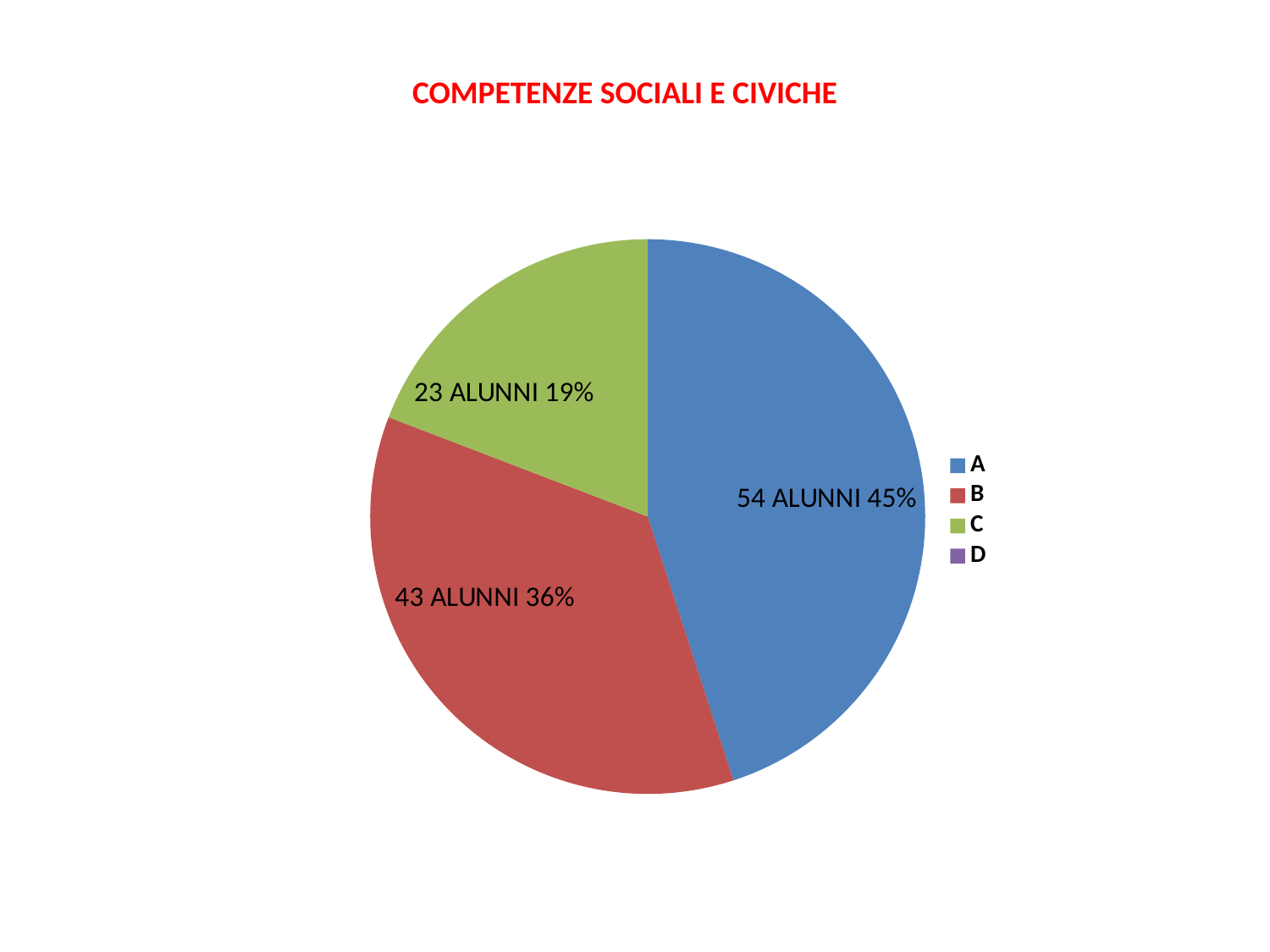
What kind of chart is shown on the slide? pie chart What is the data label for category A? 54 ALUNNI 45% Which visible category has the smallest slice? C How many slices are visible in the pie? 3 How many more alunni are in category A than in category C? 31 How many entries does the legend list? 4 Which category has the largest slice? A Which is larger, the slice for B or the slice for C? B What share of the pie does category B represent? 36% What is the data label for category B? 43 ALUNNI 36% What is the data label for category C? 23 ALUNNI 19% What is the title of the chart? COMPETENZE SOCIALI E CIVICHE